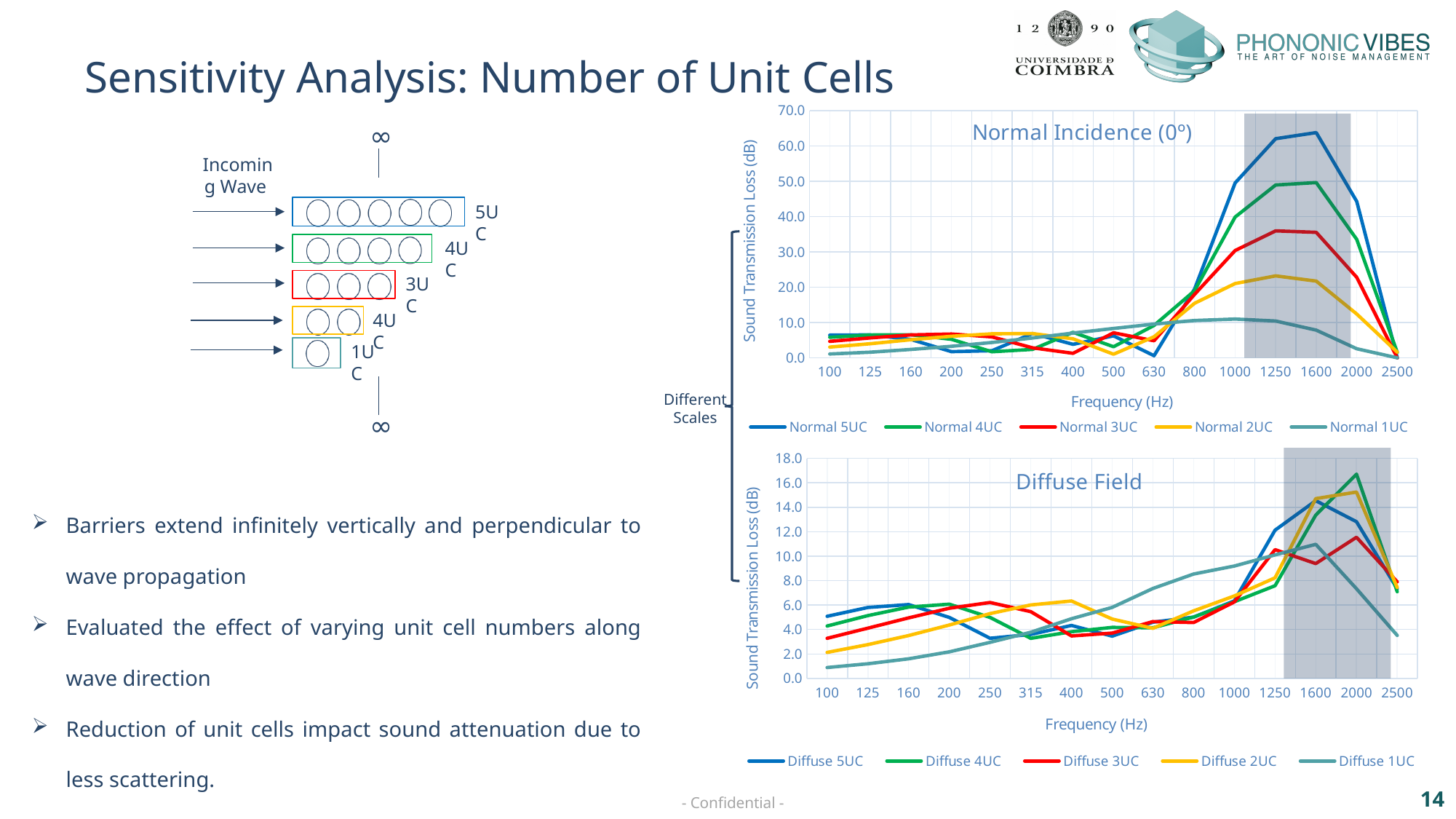
In the 'Normal Incidence (0°)' chart, at 1600 Hz, which is larger: Normal 5UC or Normal 2UC? Normal 5UC In the 'Diffuse Field' chart, is the value for Diffuse 4UC at 2000 Hz greater or less than 14.0? greater What kind of chart is the 'Normal Incidence (0°)' chart? line chart How many series does the legend of the 'Diffuse Field' chart list? 5 In the 'Normal Incidence (0°)' chart, does the Normal 5UC series rise or fall between 630 Hz and 1600 Hz? rise In the 'Normal Incidence (0°)' chart, is the value for Normal 5UC at 1600 Hz greater or less than 50.0? greater In the 'Diffuse Field' chart, which series reaches the highest peak value? Diffuse 4UC How many frequency points are shown on the x axis of the 'Normal Incidence (0°)' chart? 15 What is the title of the lower chart on the slide? Diffuse Field In the 'Diffuse Field' chart, is the value for Diffuse 1UC at 100 Hz greater or less than 2.0? less In the 'Normal Incidence (0°)' chart, which series reaches the highest sound transmission loss? Normal 5UC